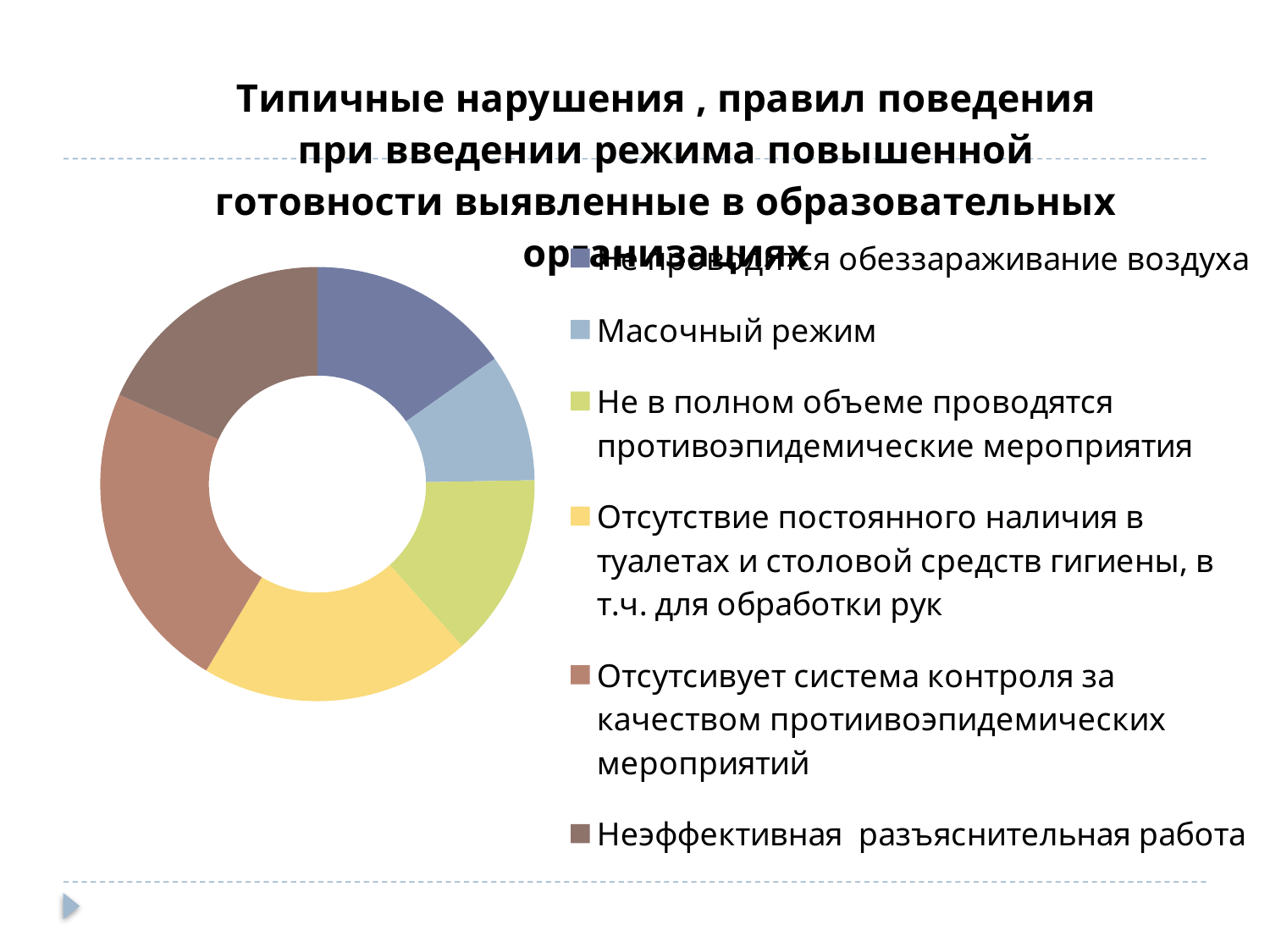
What colour is the slice for "Масочный режим" in the doughnut chart? light blue Which category has the smallest slice in the doughnut chart? Масочный режим Which category has the largest slice in the doughnut chart? Отсутсивует система контроля за качеством протиивоэпидемических мероприятий Which slice is larger: "Отсутсивует система контроля за качеством противиэпидемических мероприятий" or "Масочный режим"? Отсутсивует система контроля за качеством противиэпидемических мероприятий Which slice is larger: "Масочный режим" or "Не в полном объеме проводятся противоэпидемические мероприятия"? Не в полном объеме проводятся противоэпидемические мероприятия Which slice is larger: "Масочный режим" or "Отсутствие постоянного наличия в туалетах и столовой средств гигиены, в т.ч. для обработки рук"? Отсутствие постоянного наличия в туалетах и столовой средств гигиены, в т.ч. для обработки рук What kind of chart is shown on the slide? doughnut chart How many categories does the doughnut chart show? 6 What colour is the slice for "Неэффективная разъяснительная работа" in the doughnut chart? dark brown